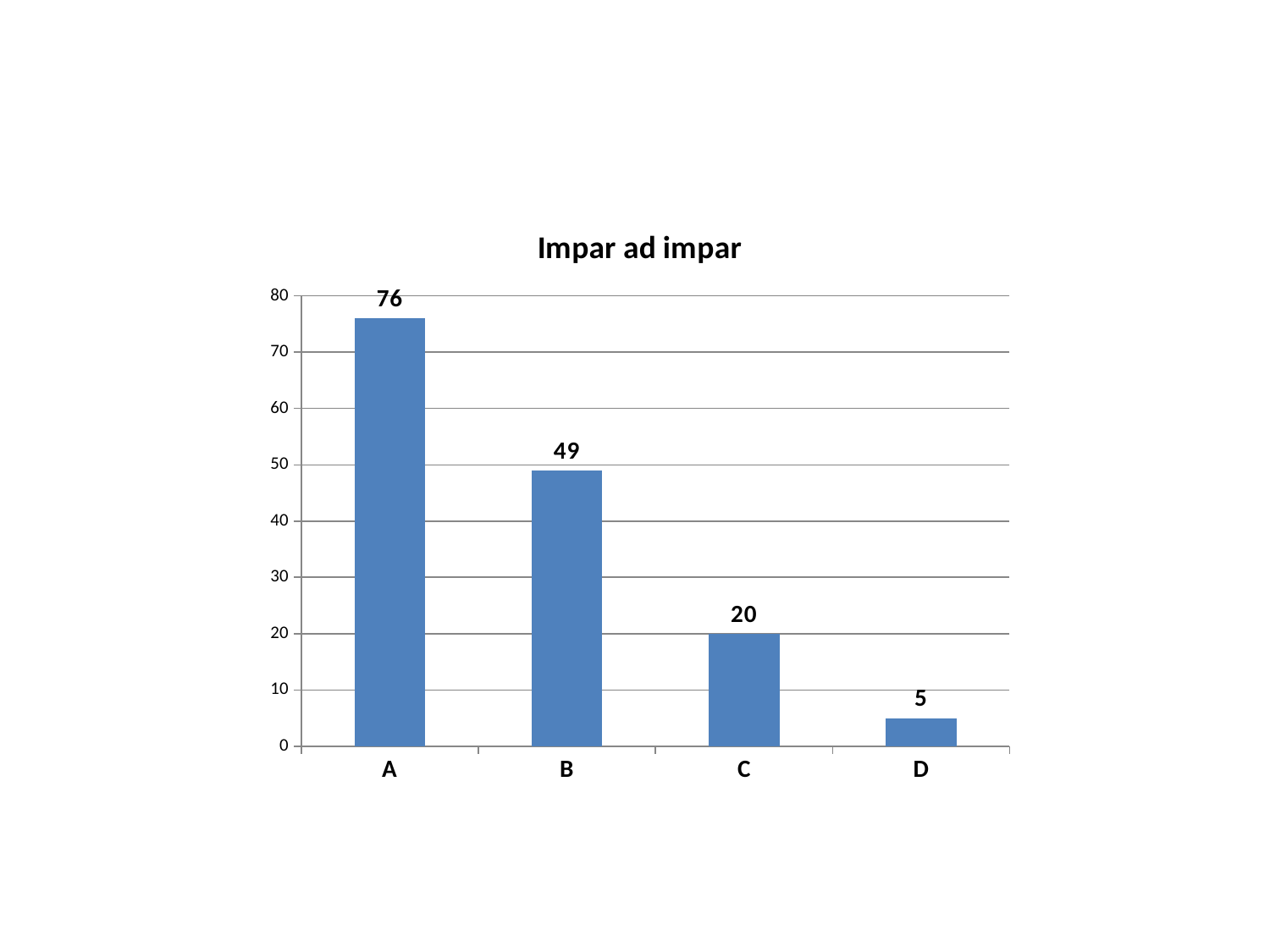
What is the value for category B? 49 What is the title of the chart? Impar ad impar Which category has the highest value? A What kind of chart is shown? bar chart Which category has the lowest value? D Is the value for B greater or less than 40? greater What is the value for category A? 76 Which is larger, the value for C or the value for D? C What is the difference between the values for A and B? 27 What is the value for category C? 20 What is the value for category D? 5 How many categories are shown on the x axis? 4